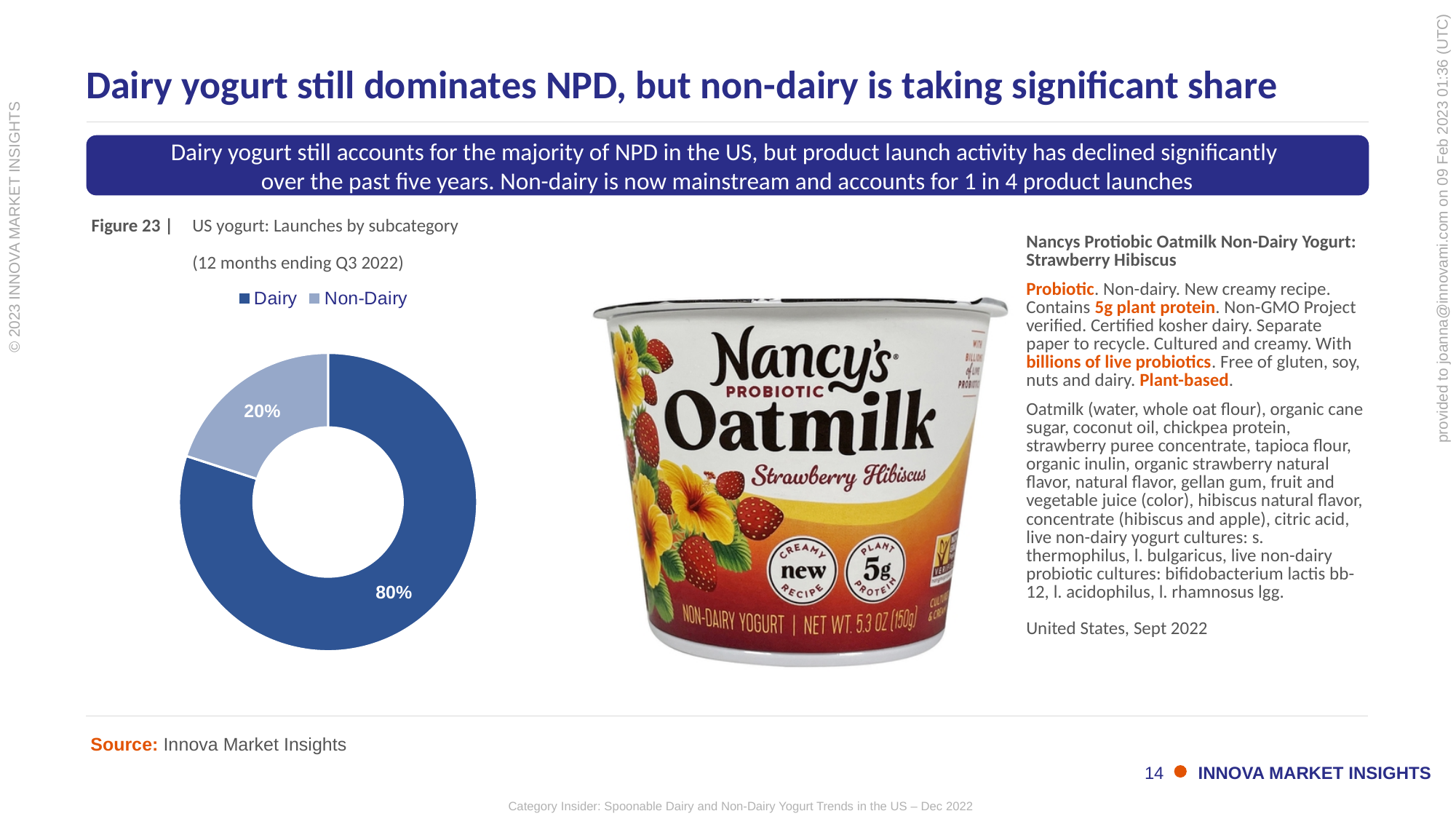
What is the figure number of the chart on the slide? Figure 23 What share of US yogurt launches is Dairy in the donut chart? 80% What type of chart is used to show US yogurt launches by subcategory? Donut (pie) chart What is the difference in percentage points between the Dairy and Non-Dairy shares? 60 percentage points What share of US yogurt launches is Non-Dairy in the donut chart? 20% How many subcategories are shown in the donut chart? 2 Which subcategory has the largest share of US yogurt launches? Dairy Which subcategory has the smallest share of US yogurt launches? Non-Dairy Which is larger, the Dairy share or the Non-Dairy share? Dairy What time period does the chart cover? 12 months ending Q3 2022 How many entries does the chart legend list? 2